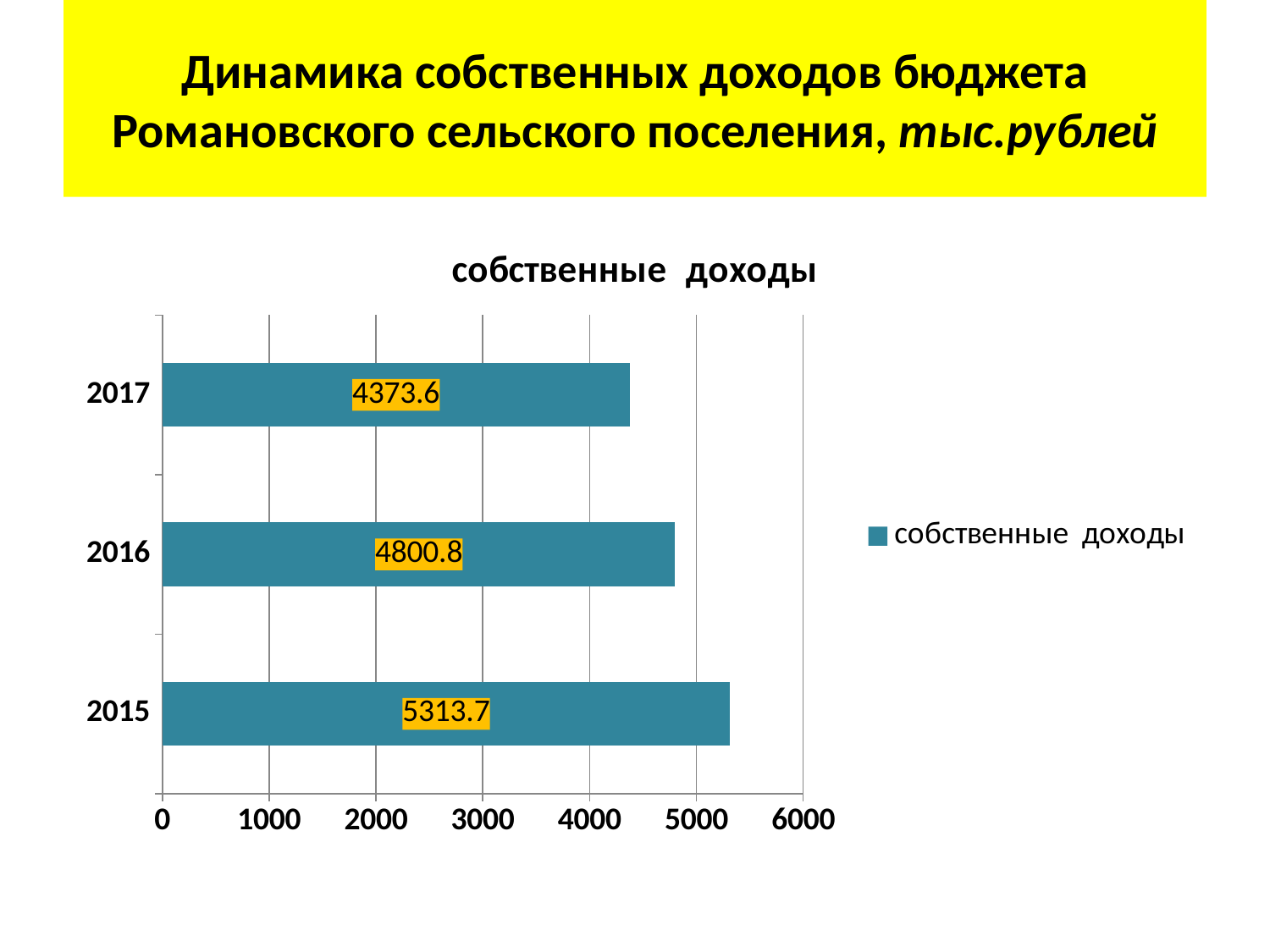
What is the value for 2016? 4800.8 What kind of chart is shown on the slide? bar chart What is the difference between the values for 2016 and 2017? 427.2 What is the difference between the values for 2015 and 2017? 940.1 How many years are shown in the chart? 3 Is the value for 2015 greater or less than 5000? greater What is the value for 2015? 5313.7 What is the title of the chart? собственные доходы Which year has the lowest value? 2017 Which year has the highest value? 2015 Which is larger, the value for 2016 or the value for 2017? 2016 What is the value for 2017? 4373.6